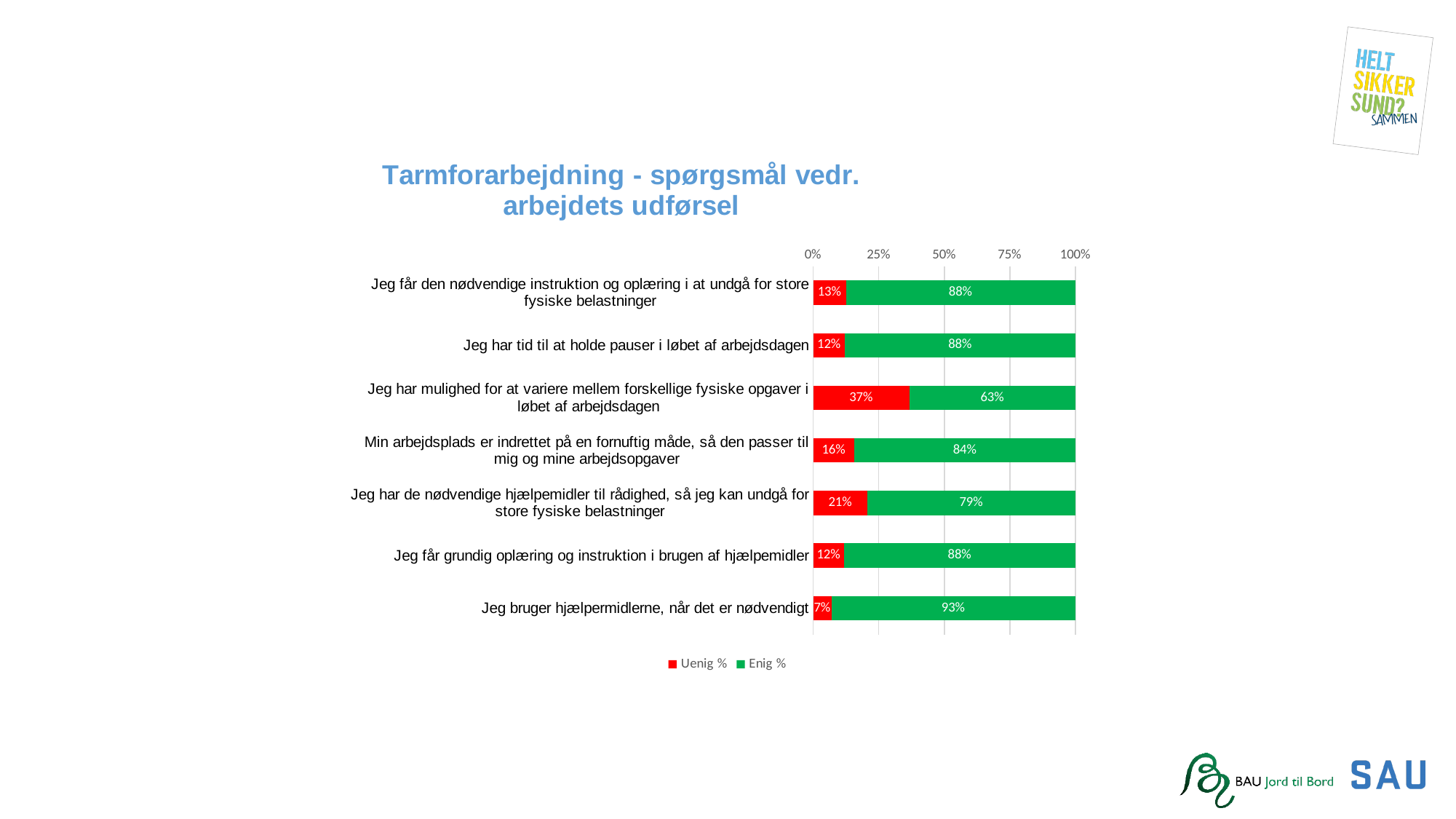
What is the difference in Enig % between "Jeg bruger hjælpermidlerne, når det er nødvendigt" and "Jeg har mulighed for at variere mellem forskellige fysiske opgaver i løbet af arbejdsdagen"? 30 percentage points What is the Enig % value for "Jeg bruger hjælpermidlerne, når det er nødvendigt"? 93% Which statement has the highest Uenig % value? Jeg har mulighed for at variere mellem forskellige fysiske opgaver i løbet af arbejdsdagen What type of chart is shown on the slide? Stacked bar chart What is the Uenig % value for "Jeg har mulighed for at variere mellem forskellige fysiske opgaver i løbet af arbejdsdagen"? 37% What is the Enig % value for "Jeg har de nødvendige hjælpemidler til rådighed, så jeg kan undgå for store fysiske belastninger"? 79% Which has a larger Uenig % value: "Jeg har de nødvendige hjælpemidler til rådighed, så jeg kan undgå for store fysiske belastninger" or "Jeg har tid til at holde pauser i løbet af arbejdsdagen"? Jeg har de nødvendige hjælpemidler til rådighed, så jeg kan undgå for store fysiske belastninger Which statement has the highest Enig % value? Jeg bruger hjælpermidlerne, når det er nødvendigt Which statement has the lowest Enig % value? Jeg har mulighed for at variere mellem forskellige fysiske opgaver i løbet af arbejdsdagen What is the Uenig % value for "Min arbejdsplads er indrettet på en fornuftig måde, så den passer til mig og mine arbejdsopgaver"? 16% How many series does the legend list? 2 How many statements (categories) are shown in the chart? 7